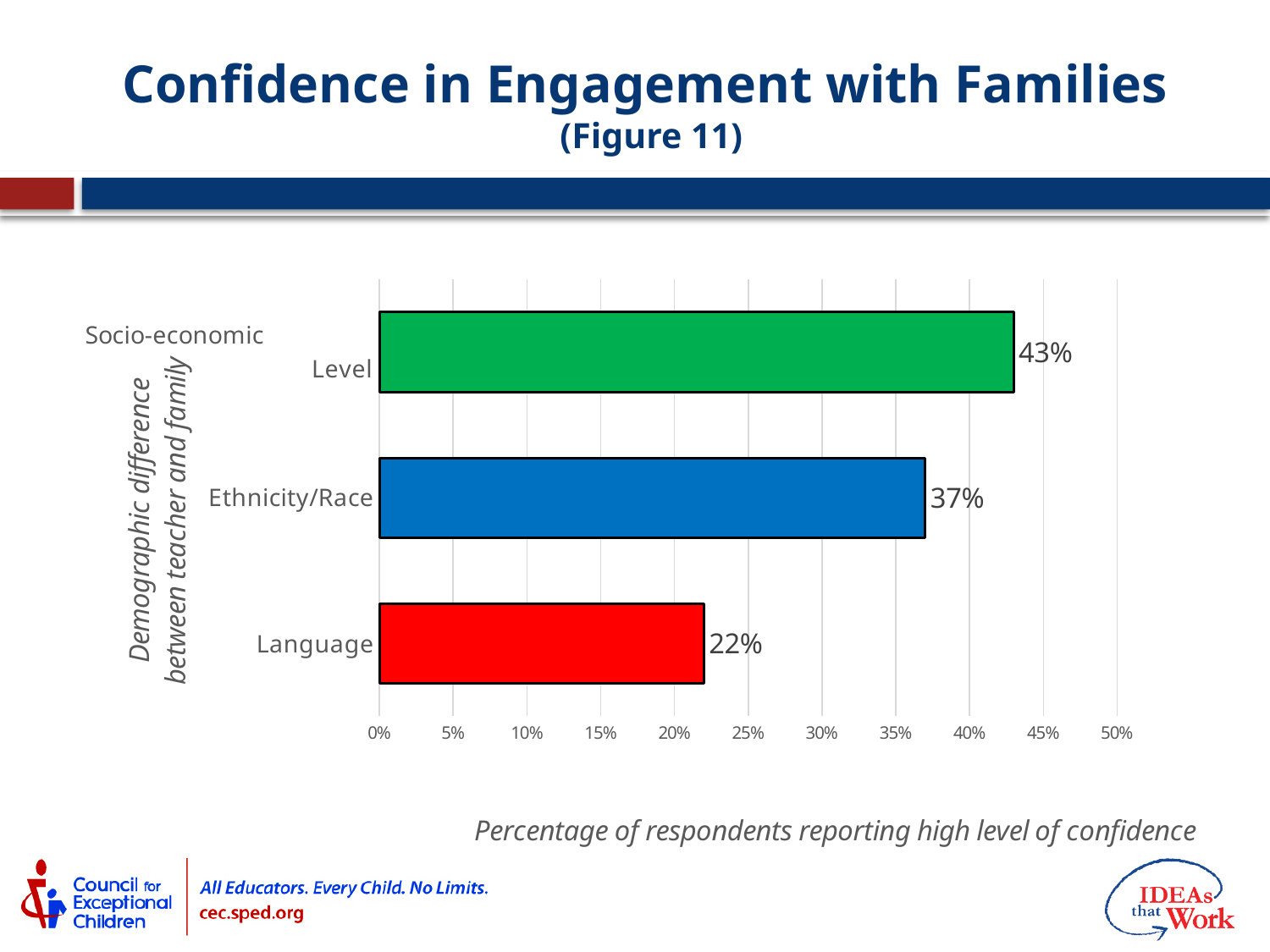
What is the difference between the values for Ethnicity/Race and Language? 15% Which is larger, the value for Ethnicity/Race or the value for Language? Ethnicity/Race Which demographic difference has the highest percentage of respondents reporting high confidence? Socio-economic Level How many categories are shown on the chart? 3 What is the difference between the values for Socio-economic Level and Language? 21% What is the value shown for Language? 22% What is the value shown for Ethnicity/Race? 37% What colour is the bar for Language? Red What percentage of respondents reported a high level of confidence for Socio-economic Level? 43% Is the value for Ethnicity/Race greater or less than 40%? less What kind of chart is shown on the slide? Bar chart Which demographic difference has the lowest percentage? Language